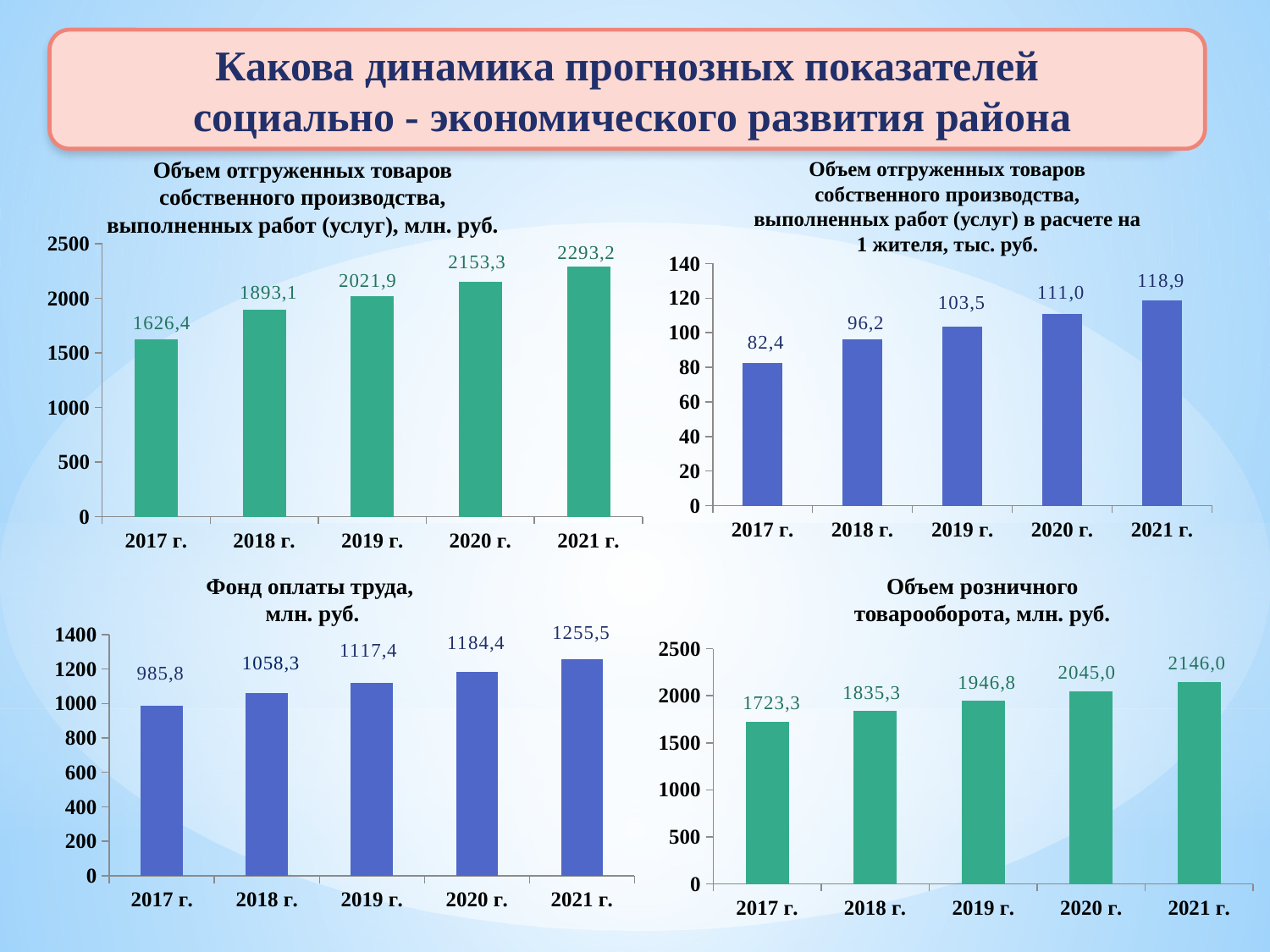
In the top-left chart, what is the difference between the values for 2021 г. and 2017 г.? 666,8 In the bottom-right chart (Объем розничного товарооборота, млн. руб.), what is the value for 2018 г.? 1835,3 In the top-right chart (per 1 resident, тыс. руб.), what is the value for 2017 г.? 82,4 In the top-left chart, which year has the highest value? 2021 г. What type of chart is the top-right chart? bar chart In the top-right chart (per 1 resident), what is the difference between the values for 2021 г. and 2017 г.? 36,5 In the top-left chart (Объем отгруженных товаров ... млн. руб.), what is the value for 2019 г.? 2021,9 In the bottom-left chart (Фонд оплаты труда), which year has the lowest value? 2017 г. In the bottom-right chart (Объем розничного товарооборота), do the values rise or fall from 2017 г. to 2021 г.? rise How many years are shown on the x axis of the bottom-left chart (Фонд оплаты труда)? 5 In the bottom-left chart (Фонд оплаты труда, млн. руб.), what is the value for 2020 г.? 1184,4 In the bottom-right chart, which is larger: the value for 2019 г. or the value for 2020 г.? 2020 г.